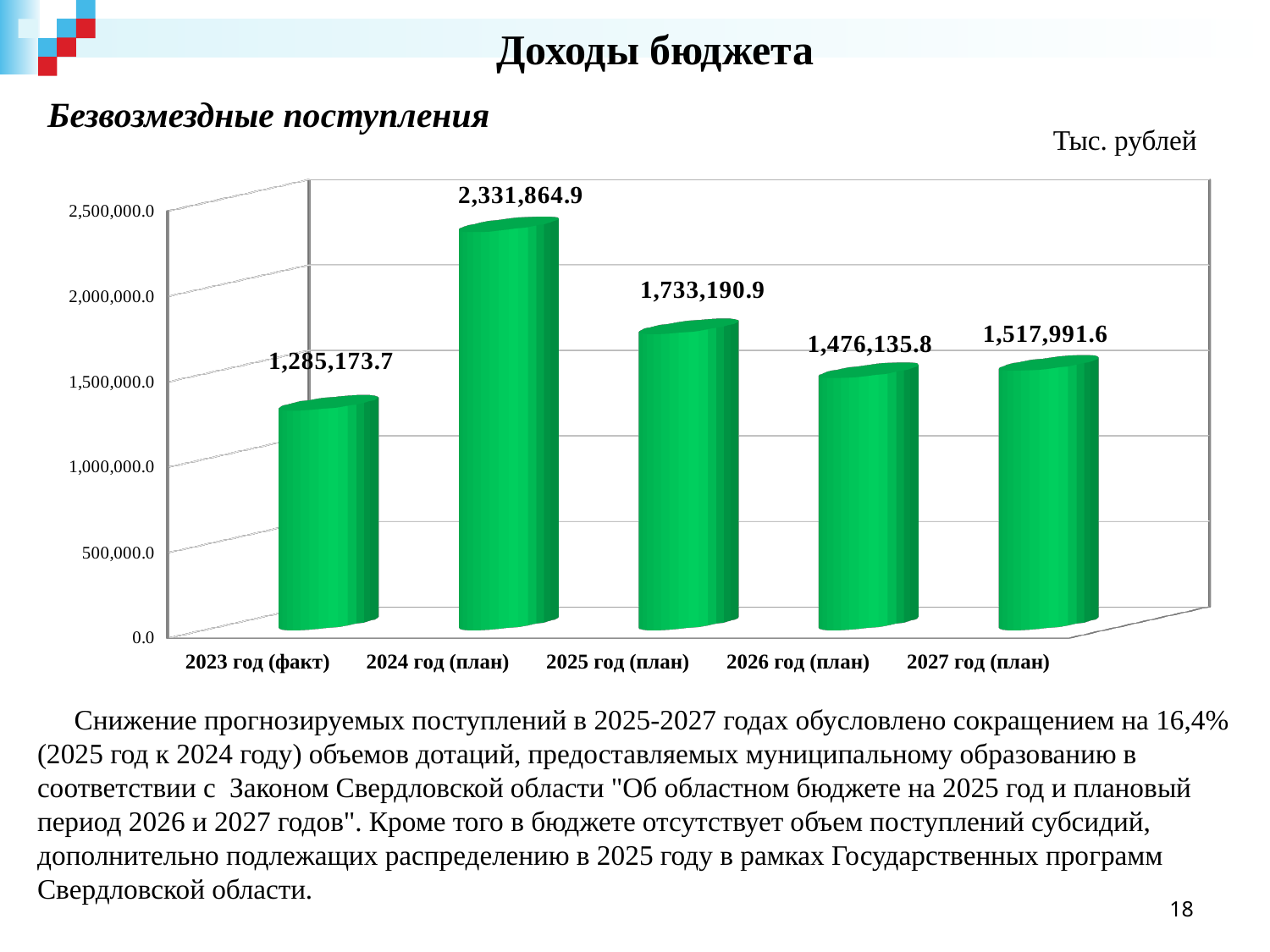
Which year has the highest value? 2024 год (план) Do the values rise or fall from 2024 год (план) to 2026 год (план)? fall What is the difference between the values for 2024 год (план) and 2023 год (факт)? 1,046,691.2 What kind of chart is shown on the slide? bar chart How many years are shown on the chart? 5 Is the value for 2023 год (факт) greater or less than 1,500,000.0? less What is the value for 2027 год (план)? 1,517,991.6 What is the value for 2023 год (факт)? 1,285,173.7 Which year has the lowest value? 2023 год (факт) What is the difference between the values for 2025 год (план) and 2026 год (план)? 257,055.1 Which is larger, the value for 2026 год (план) or 2027 год (план)? 2027 год (план) What is the value for 2025 год (план)? 1,733,190.9